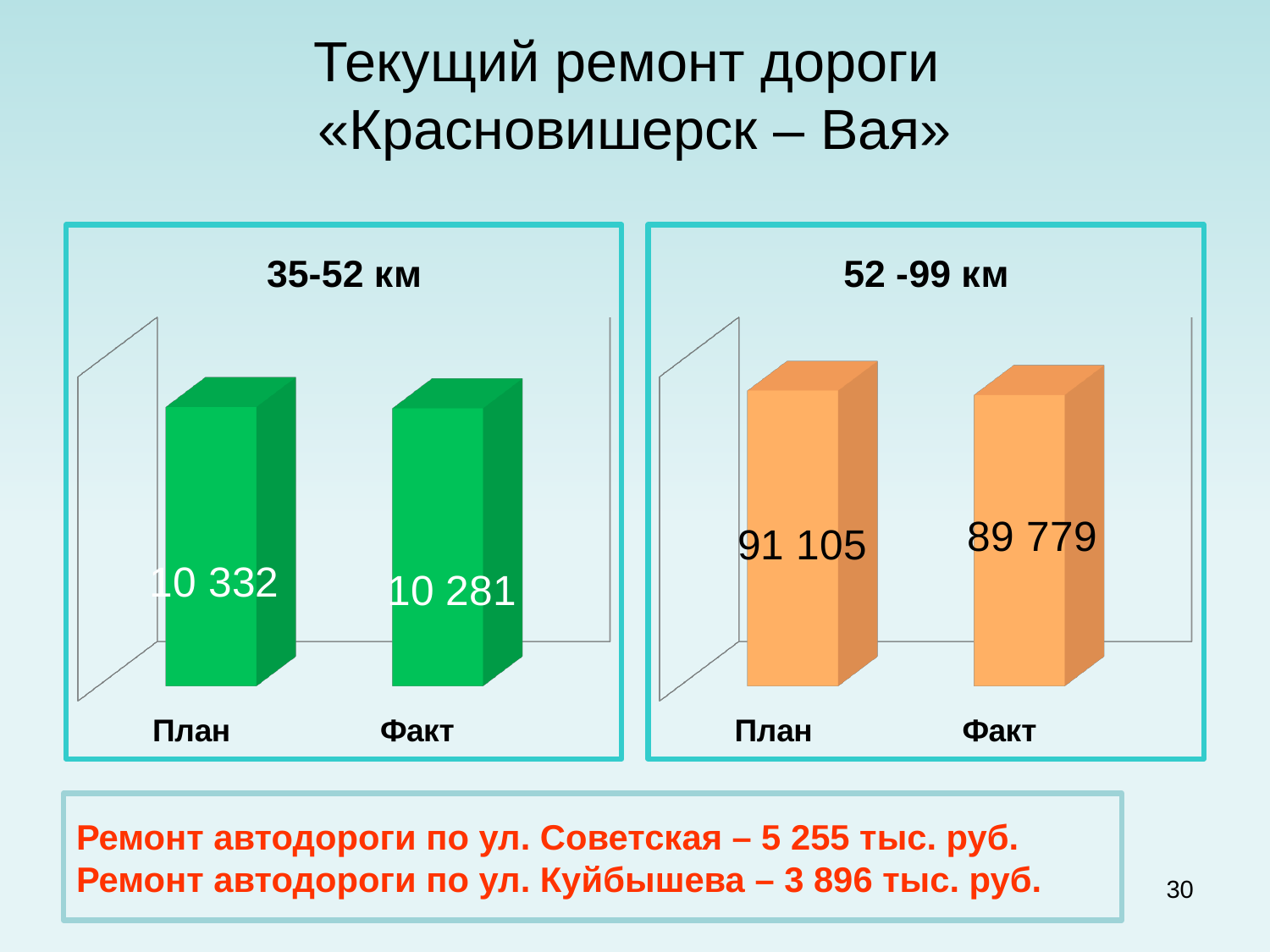
In the chart titled "52 -99 км", which category has the highest value? План In the chart titled "52 -99 км", which is larger, План or Факт? План In the chart titled "52 -99 км", what is the value for План? 91 105 What colour are the bars in the chart titled "52 -99 км"? Orange How many categories are shown in the chart titled "35-52 км"? 2 In the chart titled "35-52 км", which category has the lowest value? Факт What kind of chart is the chart titled "52 -99 км"? Bar chart In the chart titled "52 -99 км", what is the difference between План and Факт? 1 326 In the chart titled "35-52 км", what is the value for План? 10 332 In the chart titled "35-52 км", what is the value for Факт? 10 281 In the chart titled "52 -99 км", what is the value for Факт? 89 779 In the chart titled "35-52 км", what is the difference between План and Факт? 51